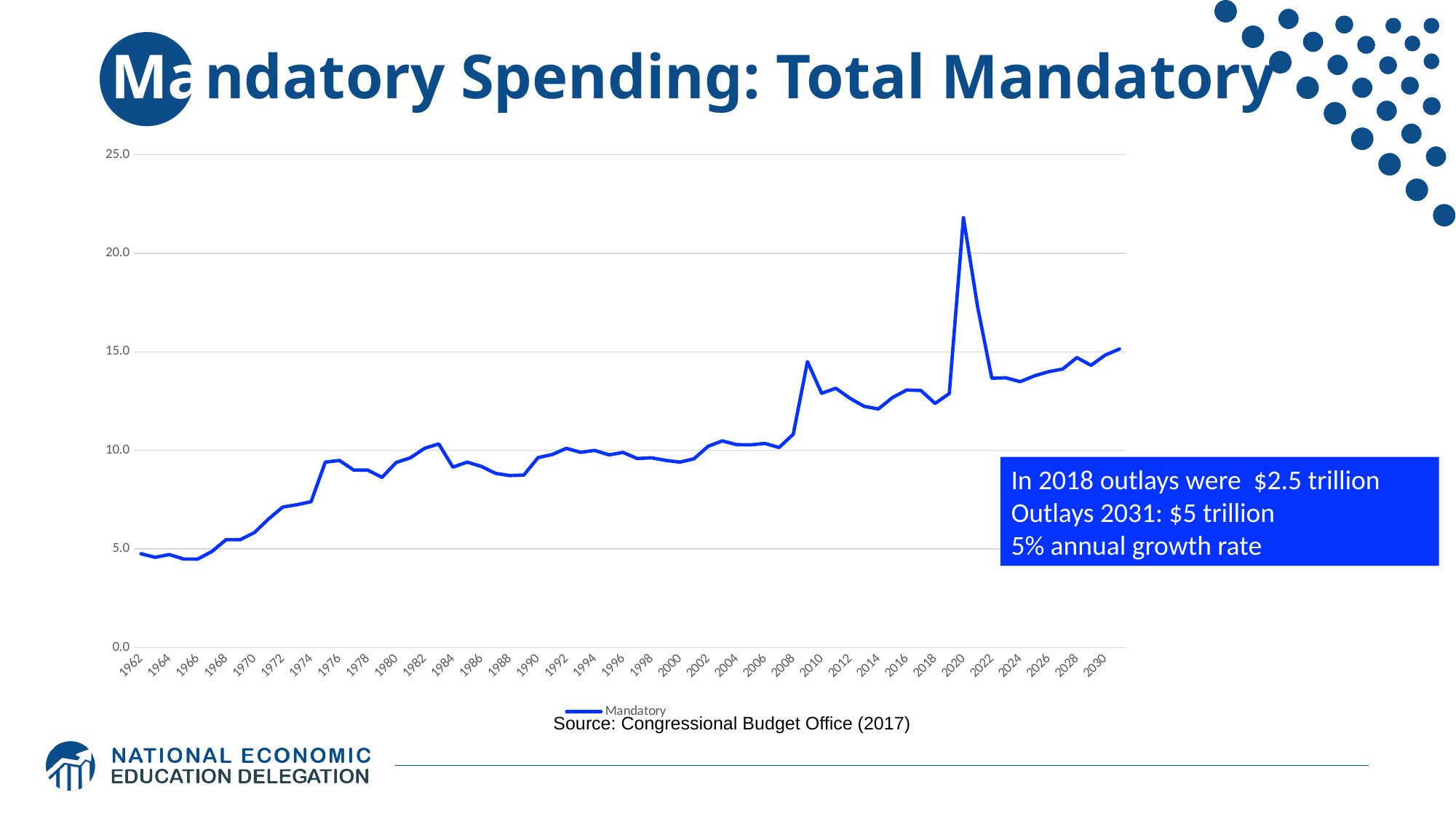
In which year does the Mandatory line reach its highest value? 2020 Is the value for 2020 greater or less than 20.0? greater Which year has the larger value, 2010 or 2020? 2020 Which year has the larger value, 1984 or 2014? 2014 How many series does the legend list? 1 What source is cited below the chart? Congressional Budget Office (2017) Is the value for 1962 greater or less than 10.0? less Is the value for 2010 greater or less than 10.0? greater What kind of chart is shown on the slide? line chart What is the name of the series shown in the legend? Mandatory Overall, does the Mandatory line rise or fall from 1962 to 2030? rise